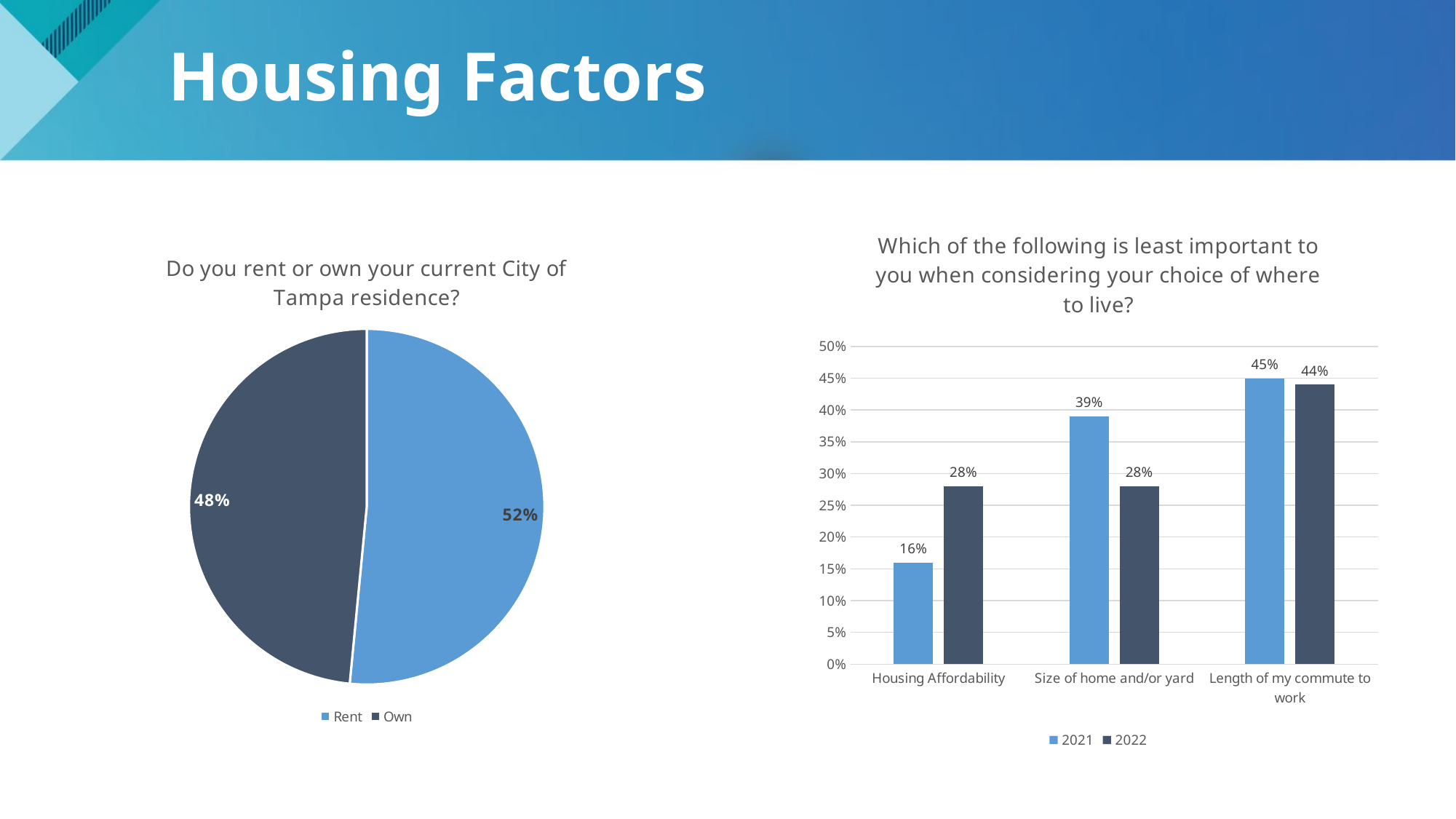
How many categories are shown on the x axis of the bar chart on the right? 3 In the bar chart on the right, what is the 2022 value for Size of home and/or yard? 28% In the pie chart 'Do you rent or own your current City of Tampa residence?', what share of respondents own? 48% In the pie chart 'Do you rent or own your current City of Tampa residence?', what share of respondents rent? 52% In the bar chart on the right, what is the 2021 value for Housing Affordability? 16% In the bar chart on the right, which category has the highest 2021 value? Length of my commute to work In the bar chart on the right, what is the difference between the 2021 and 2022 values for Size of home and/or yard? 11% How many series does the legend of the bar chart on the right list? 2 What kind of chart is the chart on the right of the slide? Bar chart What kind of chart is the chart on the left of the slide? Pie chart In the pie chart on the left, which slice is larger, Rent or Own? Rent